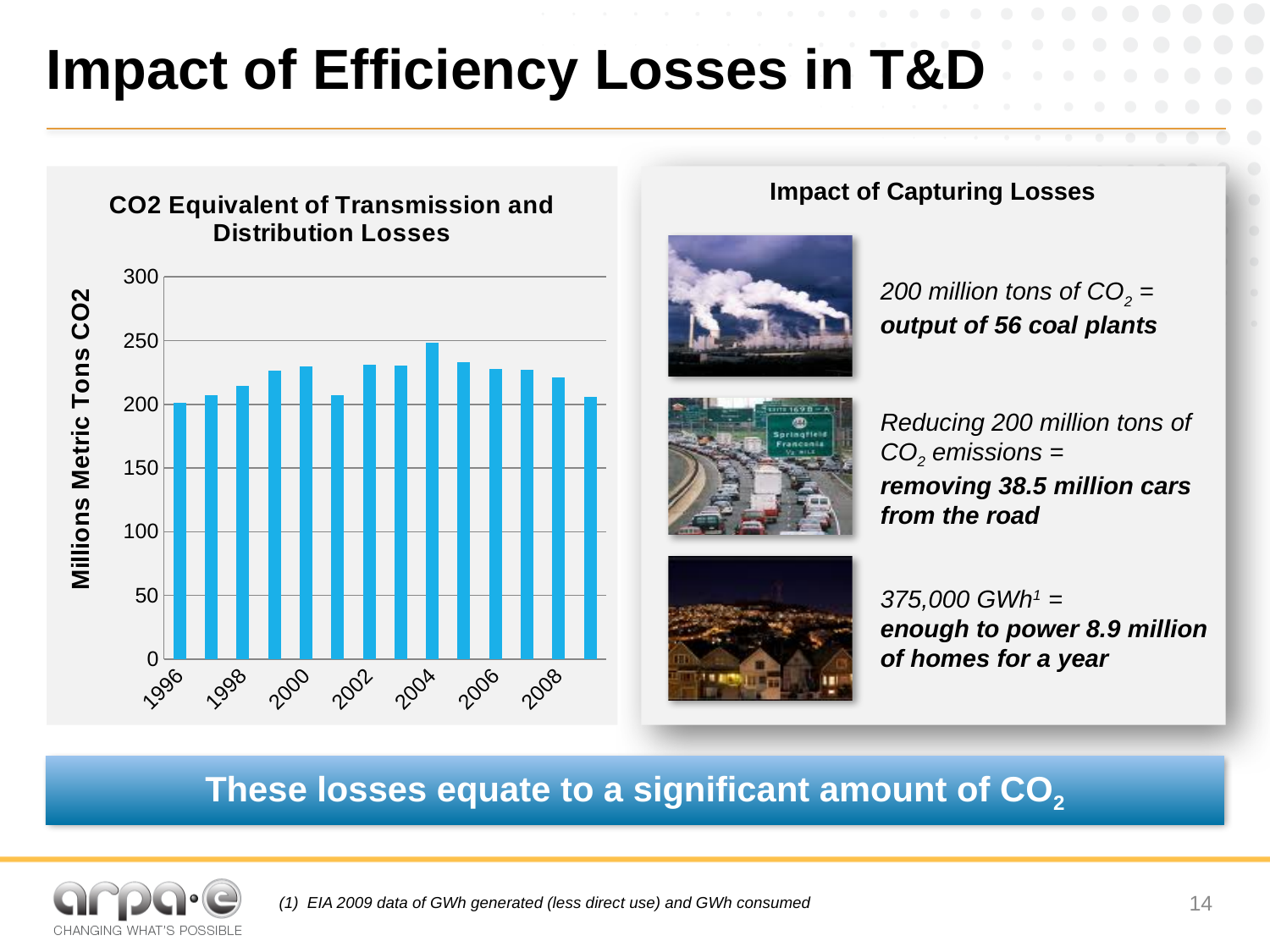
Which year has the highest value in the chart? 2004 Is the value for 2004 greater or less than 200? greater Is the value for 2000 greater or less than 200? greater Is the value for 2008 greater or less than 150? greater How many bars (years) are plotted in the chart? 14 Which is larger, the value for 2004 or the value for 2001? 2004 Which is larger, the value for 2000 or the value for 1996? 2000 What is the title of the chart on the slide? CO2 Equivalent of Transmission and Distribution Losses Do the values rise or fall from 2004 to 2009? fall What kind of chart is shown on the slide? bar chart What is the label on the vertical axis of the chart? Millions Metric Tons CO2